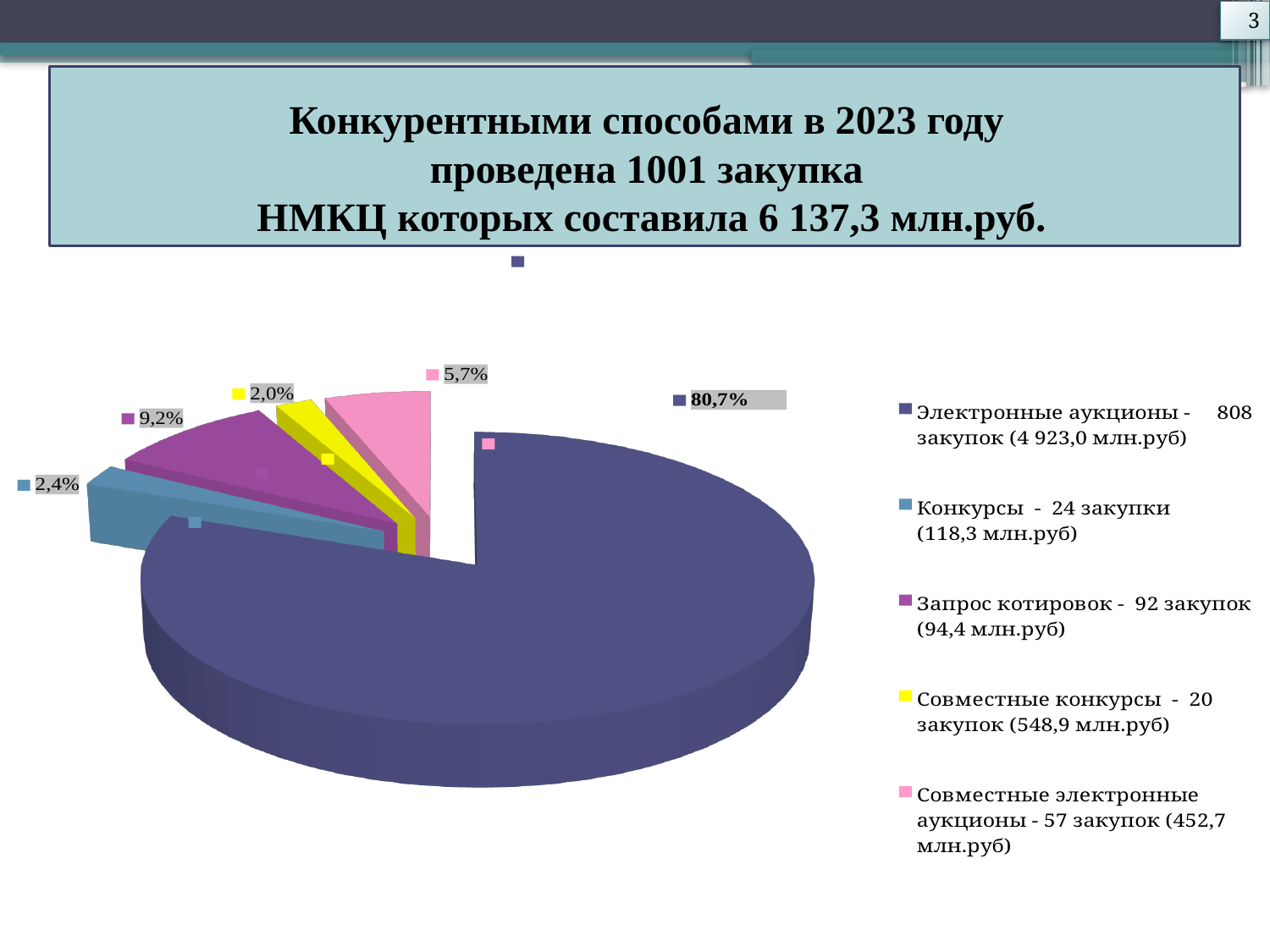
What is the difference in percentage points between the Запрос котировок slice and the Совместные электронные аукционы slice? 3,5 How many entries does the legend list? 5 Which slice is larger: Запрос котировок or Совместные электронные аукционы? Запрос котировок What share of the pie does Совместные конкурсы have? 2,0% What share of the pie does Электронные аукционы have? 80,7% What share of the pie does Совместные электронные аукционы have? 5,7% What kind of chart is shown on the slide? pie chart How many slices does the pie chart have? 5 Which category has the smallest slice of the pie? Совместные конкурсы Which category has the largest slice of the pie? Электронные аукционы